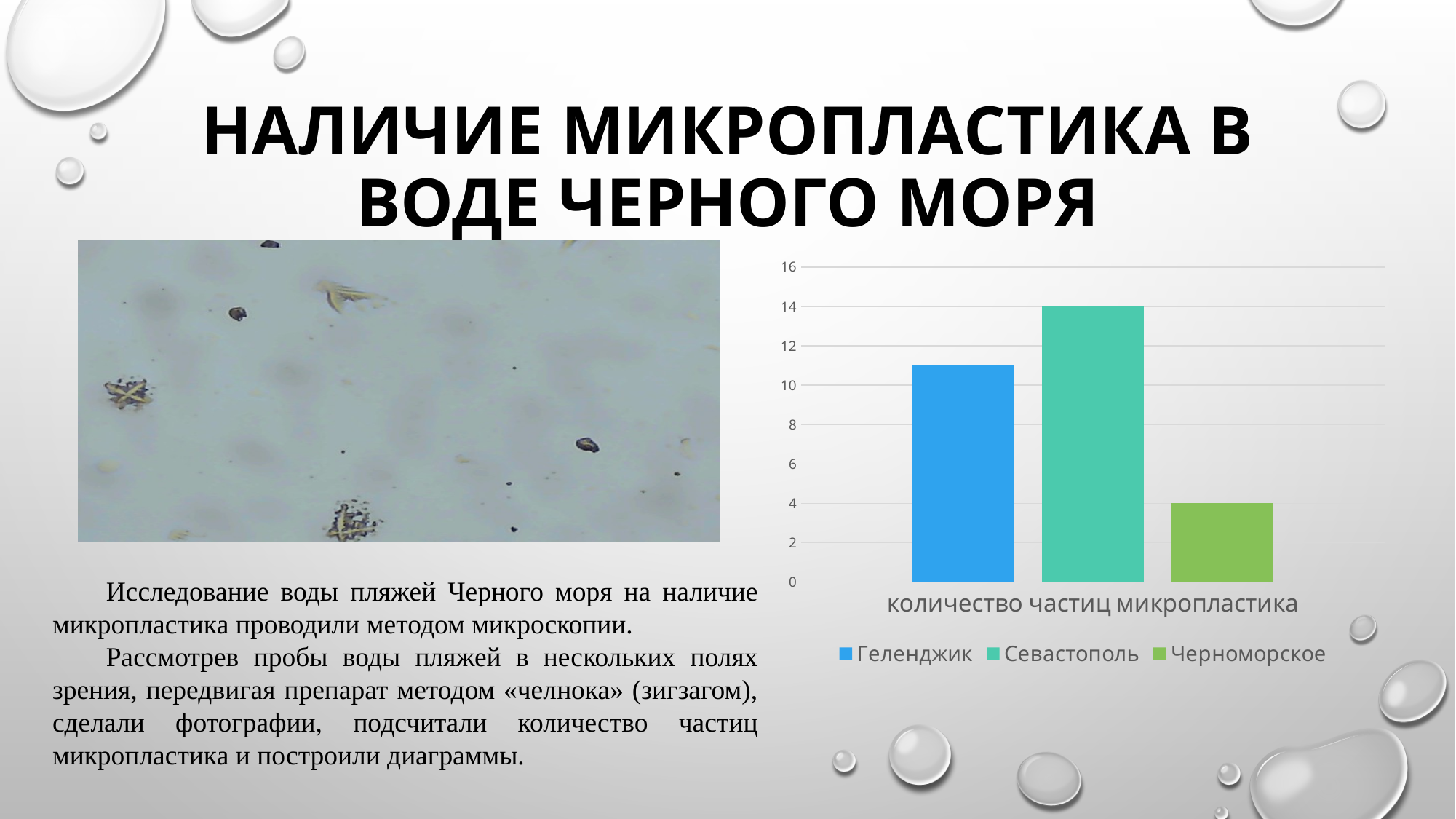
What kind of chart is shown on the slide? bar chart What is the label on the category axis of the chart? количество частиц микропластика Which series has the highest value? Севастополь Which series has the lowest value? Черноморское Which is larger, the value for Геленджик or the value for Севастополь? Севастополь Is the value for Геленджик greater or less than 10? greater What colour is the bar for Черноморское? green What is the value for Черноморское? 4 How many series does the chart legend list? 3 What is the value for Севастополь? 14 What is the difference between the values for Севастополь and Черноморское? 10 Is the value for Геленджик greater or less than 12? less